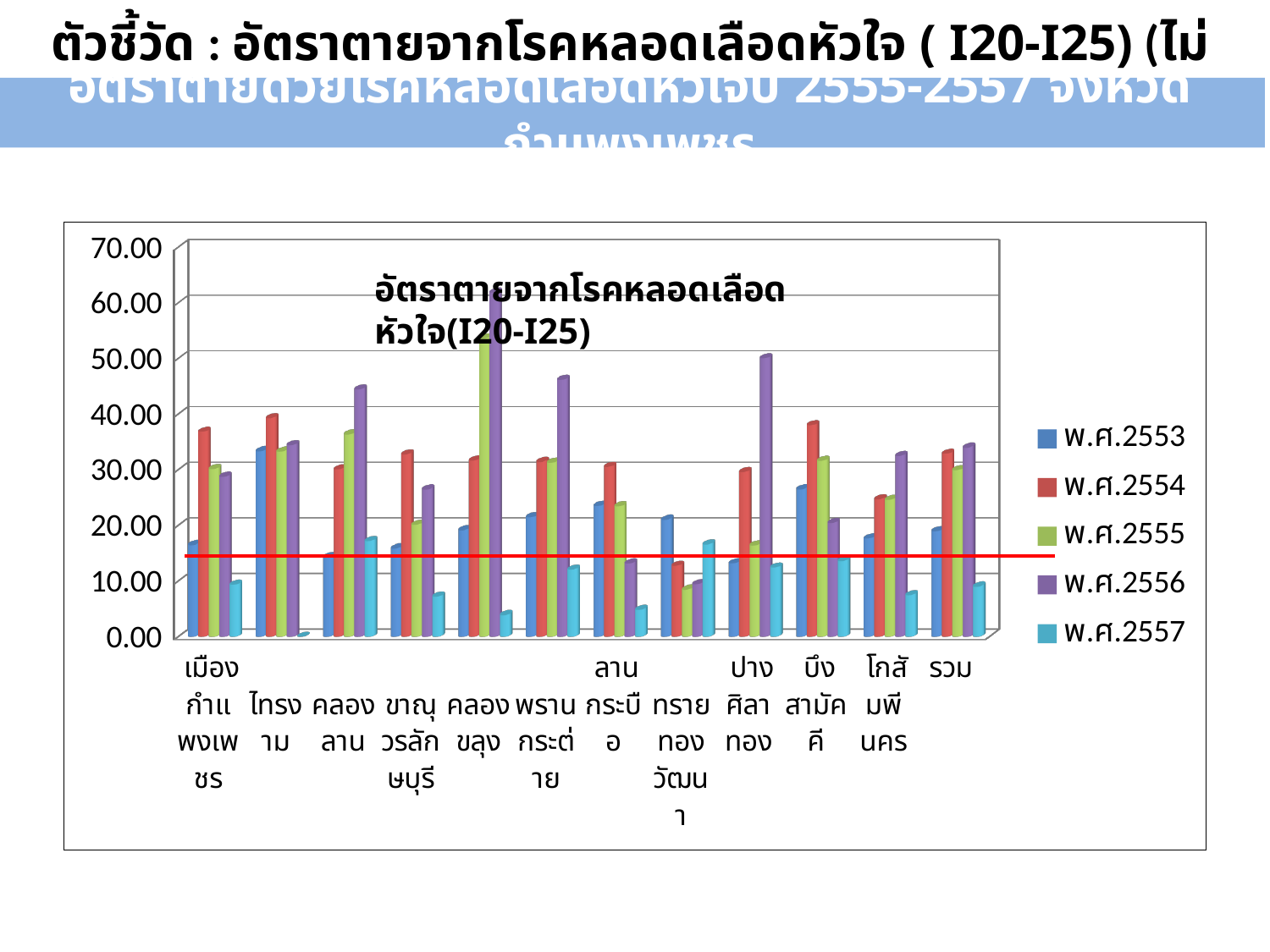
For คลองขลุง, which is larger: the value for พ.ศ.2556 or the value for พ.ศ.2557? พ.ศ.2556 How many series does the legend list? 5 Is the value for คลองขลุง in พ.ศ.2555 greater or less than 50.00? greater Which category has the lowest value for พ.ศ.2557? ไทรงาม Which is larger for พ.ศ.2553: the value for ไทรงาม or the value for เมืองกำแพงเพชร? ไทรงาม Is the value for ไทรงาม in พ.ศ.2557 greater or less than 10.00? less How many categories are shown along the x axis? 12 Which category has the highest value for พ.ศ.2556? คลองขลุง Which category has the highest value for พ.ศ.2555? คลองขลุง Is the value for บึงสามัคคี in พ.ศ.2554 greater or less than 30.00? greater What kind of chart is shown on the slide? bar chart What is the title of the chart? อัตราตายจากโรคหลอดเลือดหัวใจ(I20-I25)